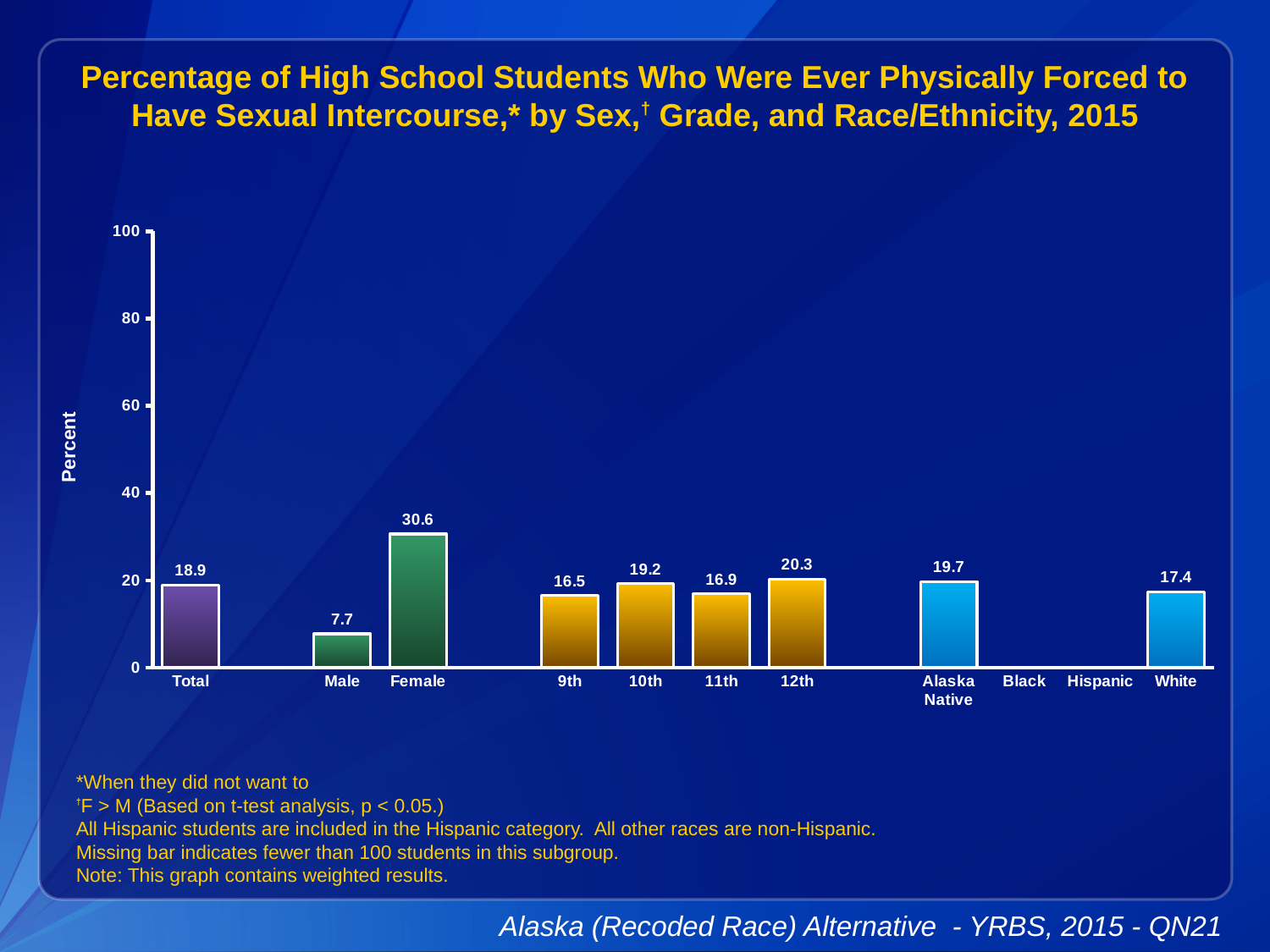
Which category has the highest value? Female What is the value for Male? 7.7 How many categories on the x axis have no bar shown? 2 What is the label of the y axis? Percent What is the value for Female? 30.6 What kind of chart is shown on the slide? bar chart What is the value for Alaska Native? 19.7 What is the difference between the Female and Male values? 22.9 What is the value for 12th grade? 20.3 Is the value for Total greater or less than 20? less Which category has the lowest value among the bars shown? Male Which is larger, the value for 10th grade or the value for 11th grade? 10th